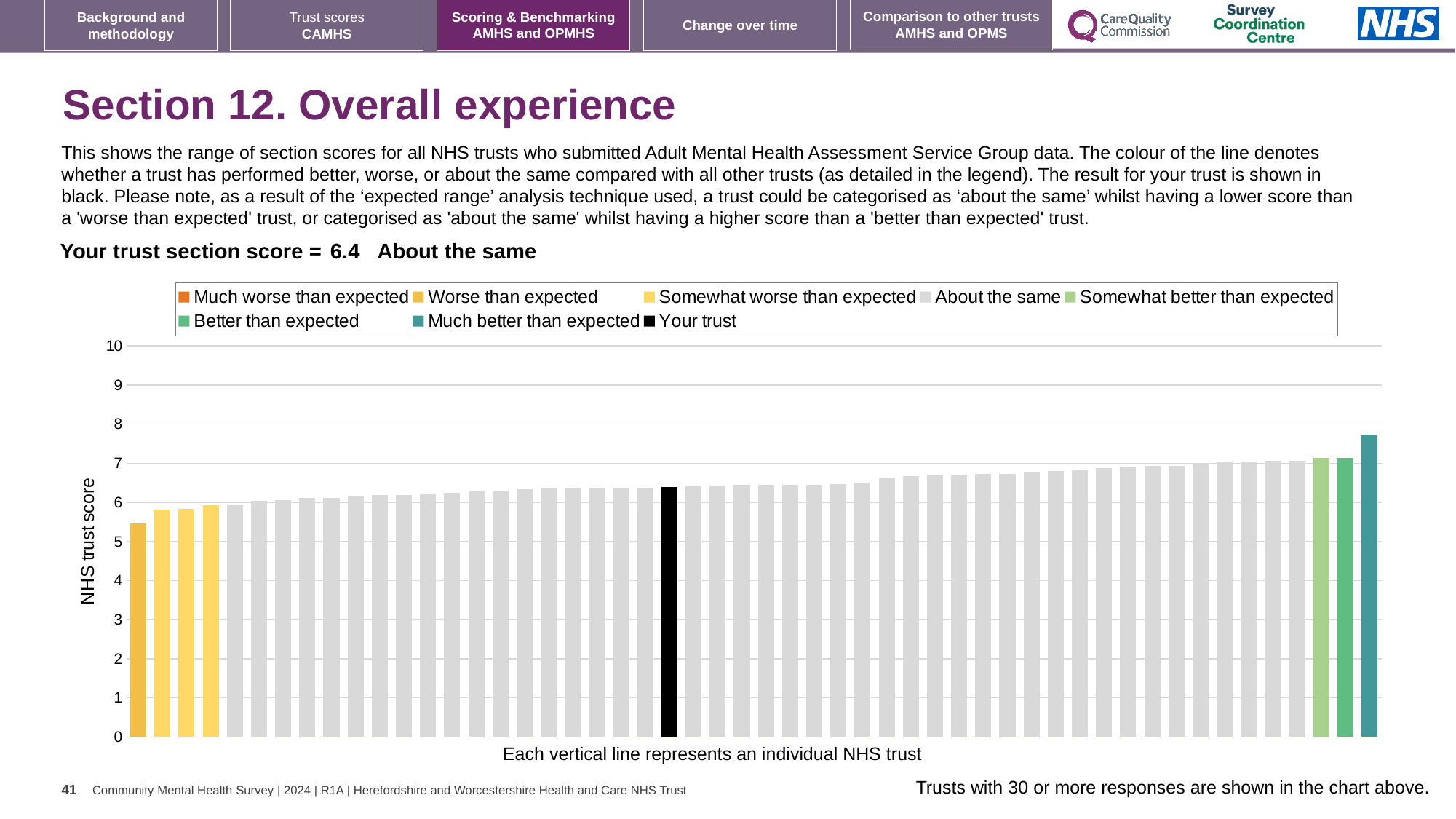
How many categories does the chart legend list? 8 What is the label on the y axis of the chart? NHS trust score Which legend category does the tallest bar belong to? Much better than expected What is the section score for your trust shown on the slide? 6.4 Is the value of the tallest bar in the chart greater or less than 8? less Is the value of the tallest bar in the chart greater or less than 7? greater Is the value of the shortest bar in the chart greater or less than 6? less Do the bar values rise or fall from left to right along the x axis? Rise What colour is used for the 'Your trust' bar in the chart? Black What kind of chart is shown on the slide? Bar chart